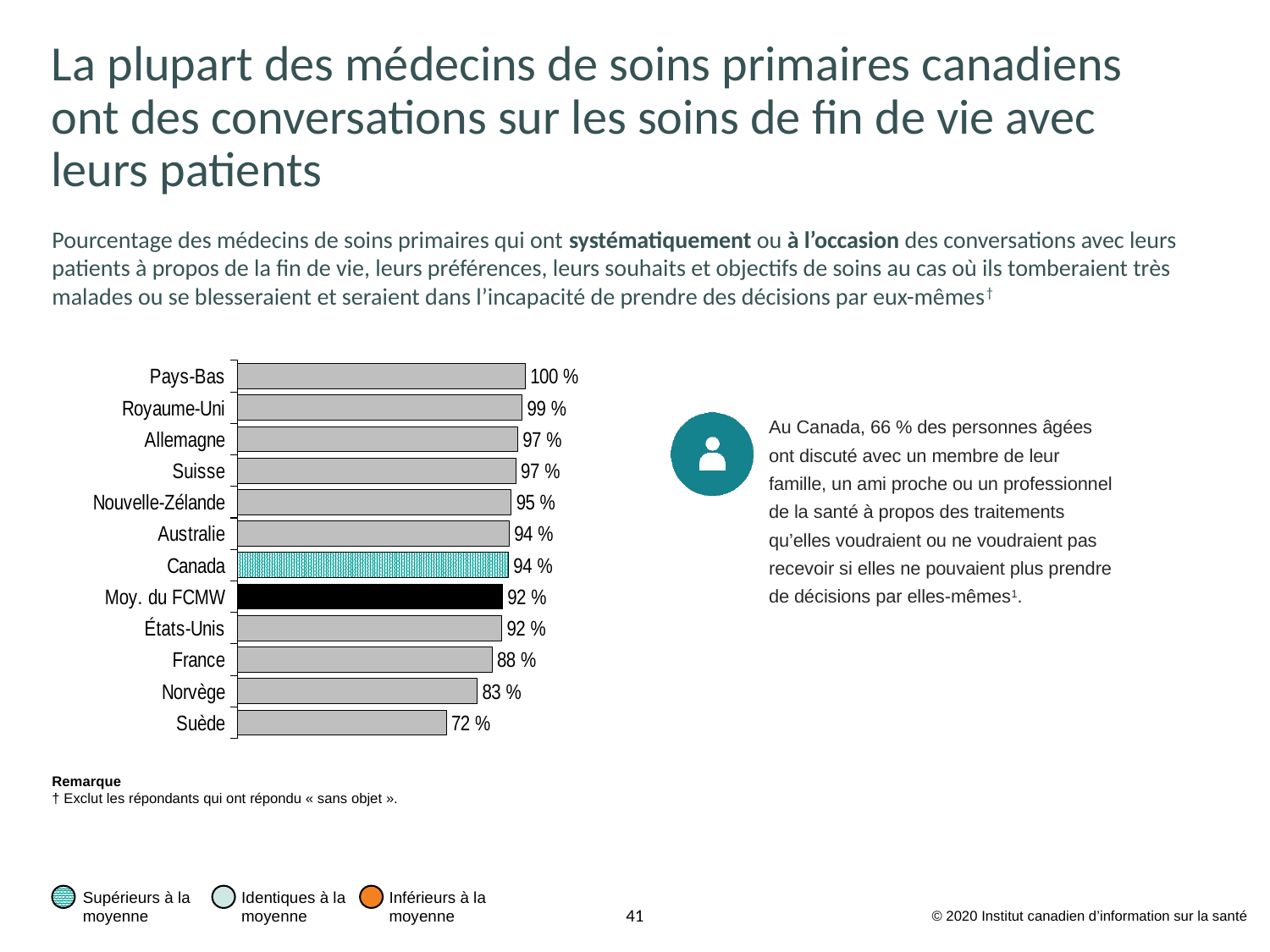
What is the difference between the values for Canada and France? 6 % Which is larger, the value for Royaume-Uni or the value for États-Unis? Royaume-Uni Which category has the highest value? Pays-Bas What is the value for Moy. du FCMW? 92 % What kind of chart is shown on the slide? Bar chart Which category has the lowest value? Suède What is the value for Suède? 72 % What is the value for Norvège? 83 % Which bar in the chart is drawn in solid black? Moy. du FCMW What is the difference between the values for Pays-Bas and Suède? 28 % What is the value for Canada? 94 % How many categories are shown in the chart? 12